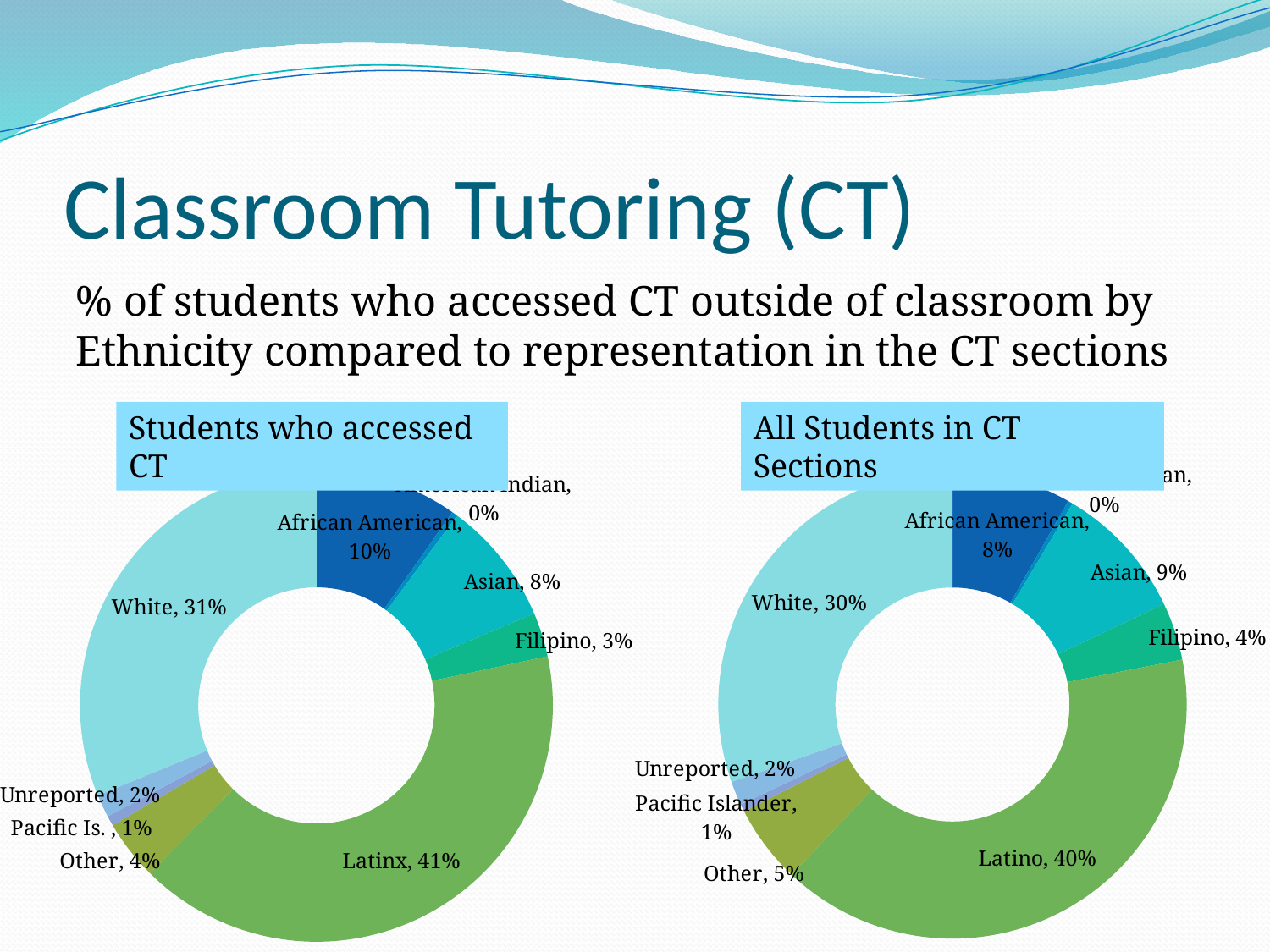
In the 'Students who accessed CT' chart, what is the difference between the Asian and Filipino shares? 5% In the 'All Students in CT Sections' chart, which is larger, Asian or Other? Asian In the 'All Students in CT Sections' chart, which ethnicity has the largest share? Latino What kind of chart is used on this slide? Doughnut (pie) chart In the 'All Students in CT Sections' chart, what percentage is Filipino? 4% In the 'All Students in CT Sections' chart, what percentage is White? 30% What is the title of the chart on the right side of the slide? All Students in CT Sections In the 'Students who accessed CT' chart, what percentage is Latinx? 41% In the 'Students who accessed CT' chart, which ethnicity has the largest share? Latinx What is the difference between the White share in the 'Students who accessed CT' chart and the White share in the 'All Students in CT Sections' chart? 1% In the 'Students who accessed CT' chart, what percentage is African American? 10% Which is larger: the African American share in the 'Students who accessed CT' chart or in the 'All Students in CT Sections' chart? Students who accessed CT